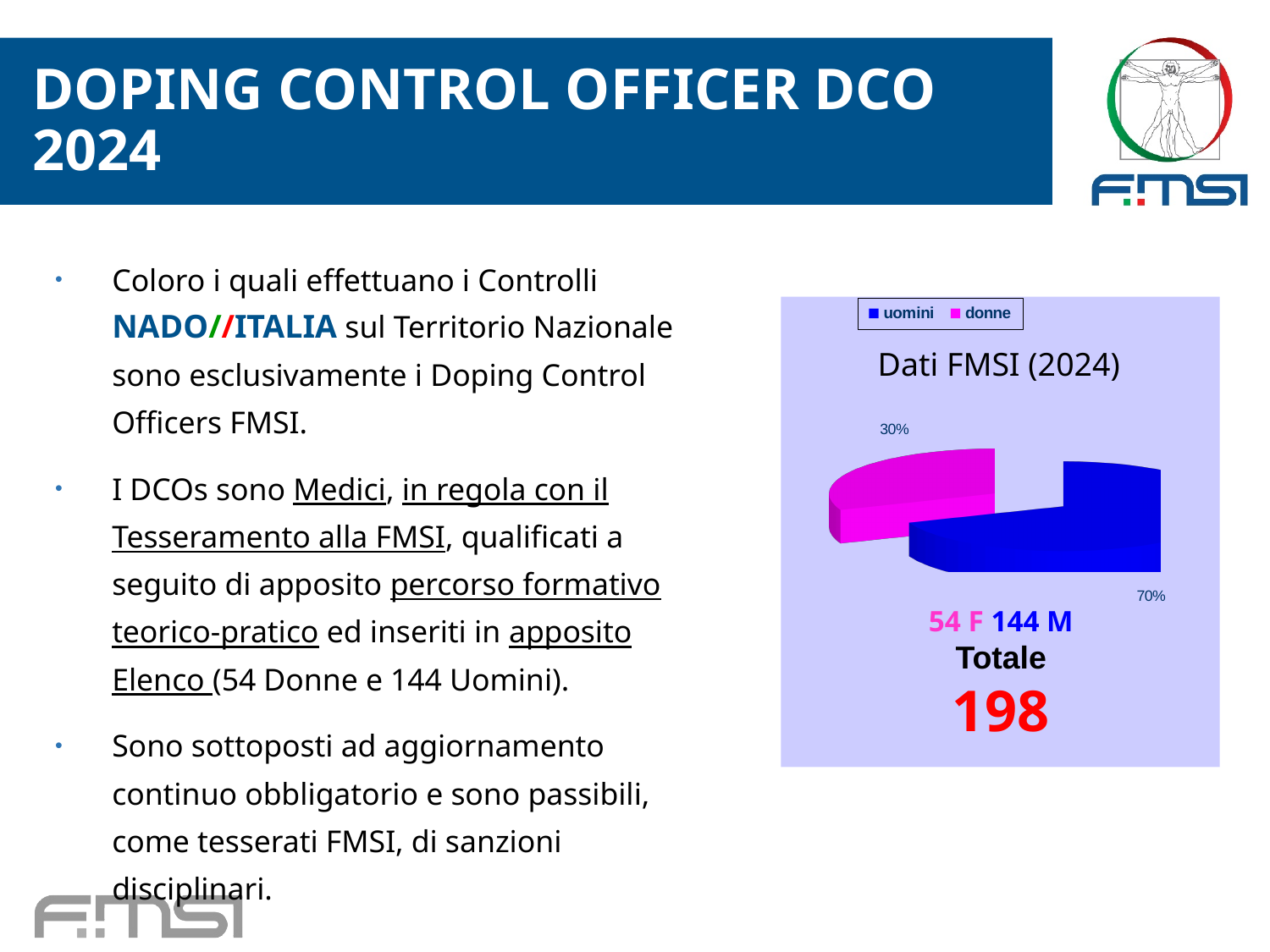
What is the title of the chart? Dati FMSI (2024) What kind of chart is shown on the slide? pie chart Which colour represents 'donne' in the pie chart? magenta What share of the pie does the 'uomini' slice represent? 70% What total is printed below the pie chart? 198 How many entries does the chart legend list? 2 Which slice of the pie is the largest? uomini How many slices does the pie chart have? 2 What share of the pie does the 'donne' slice represent? 30% What is the difference in percentage points between the 'uomini' and 'donne' slices? 40% Which is larger, the 'uomini' slice or the 'donne' slice? uomini Which slice of the pie is the smallest? donne